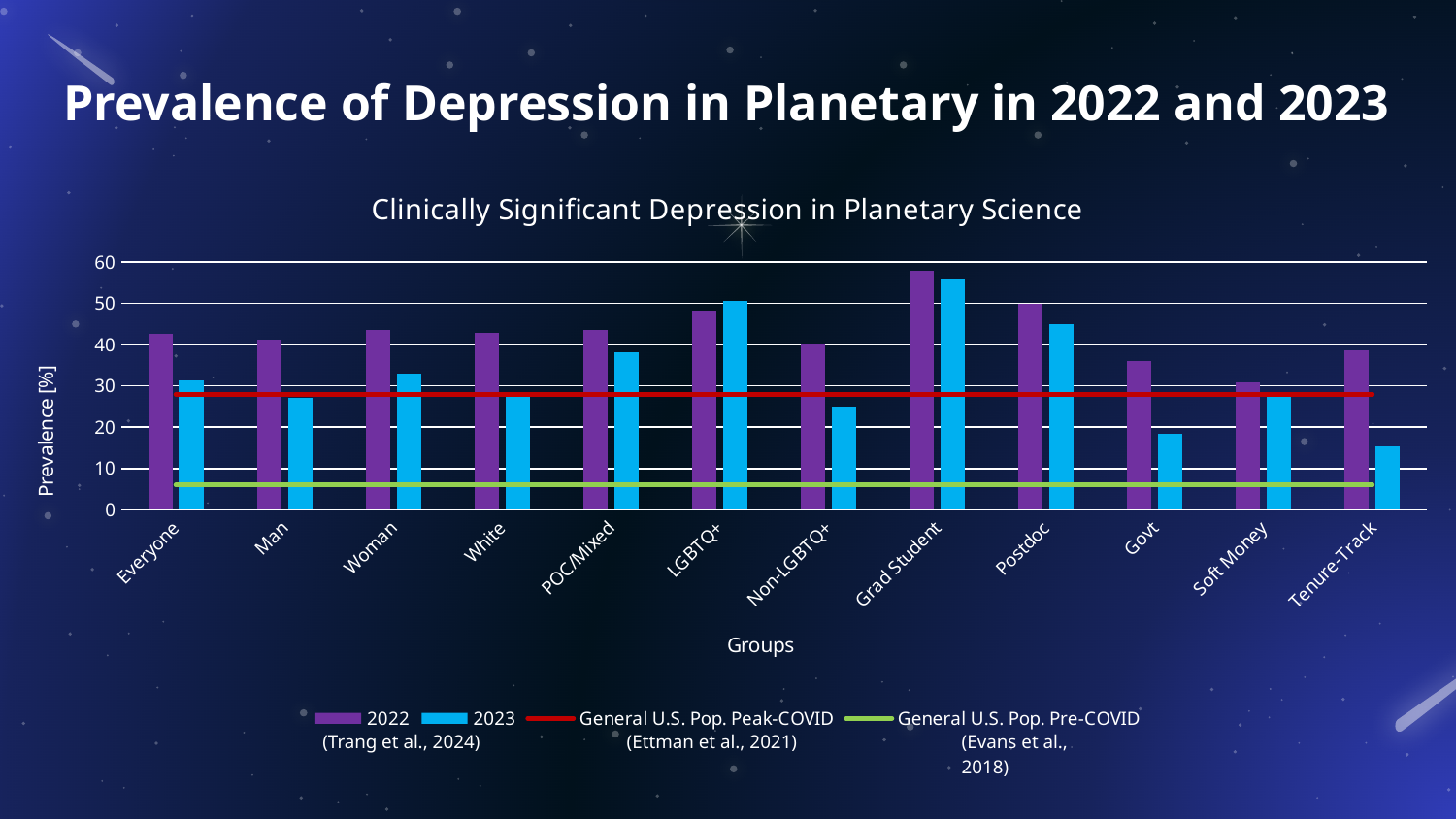
Which group has the lowest 2022 value? Soft Money Is the 2023 value for Tenure-Track greater or less than 20? less How many entries does the chart's legend list? 4 Which group has the highest 2022 value? Grad Student What kind of chart is shown on the slide? bar chart What is the label of the y axis of the chart? Prevalence [%] For Govt, which is larger, the 2022 value or the 2023 value? 2022 Is the 2023 value for LGBTQ+ greater or less than 40? greater Is the 2022 value for Grad Student greater or less than 50? greater Which group has the highest 2023 value? Grad Student How many groups are shown along the x axis of the chart? 12 For LGBTQ+, which is larger, the 2022 value or the 2023 value? 2023